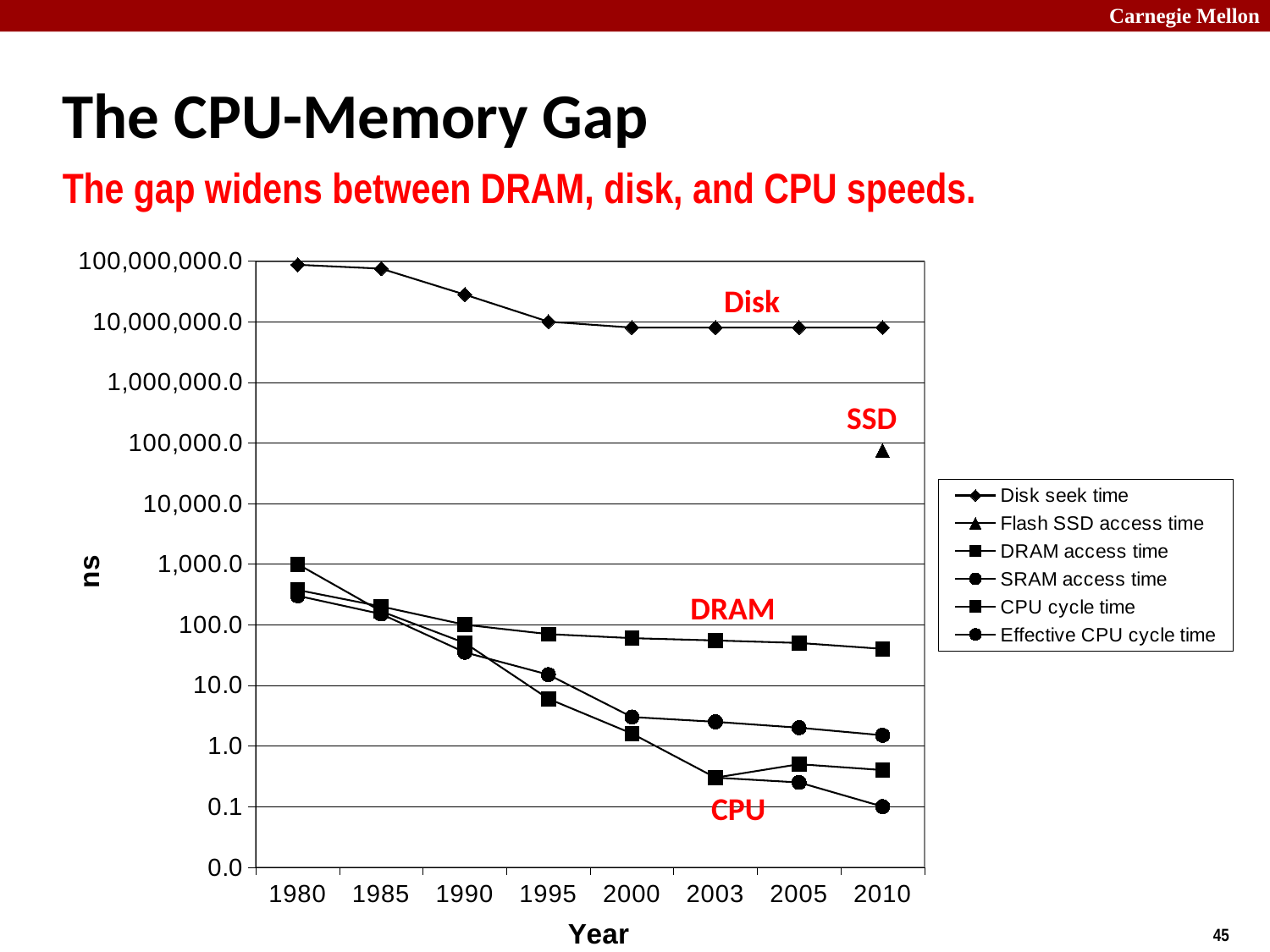
What is the Effective CPU cycle time in 2010? 0.1 Is the Disk seek time in 1980 greater or less than 10,000,000.0? greater Which series has the highest values across all years? Disk seek time Does the Disk seek time rise or fall from 1980 to 2010? fall How many years are marked on the x axis? 8 What is the label of the y axis? ns Which series has the lowest value in 2010? Effective CPU cycle time Is the DRAM access time in 2010 greater or less than 100.0? less What kind of chart is shown on the slide? line chart Is the Flash SSD access time in 2010 greater or less than 10,000.0? greater What is the Disk seek time in 1995? 10,000,000.0 How many series does the legend list? 6